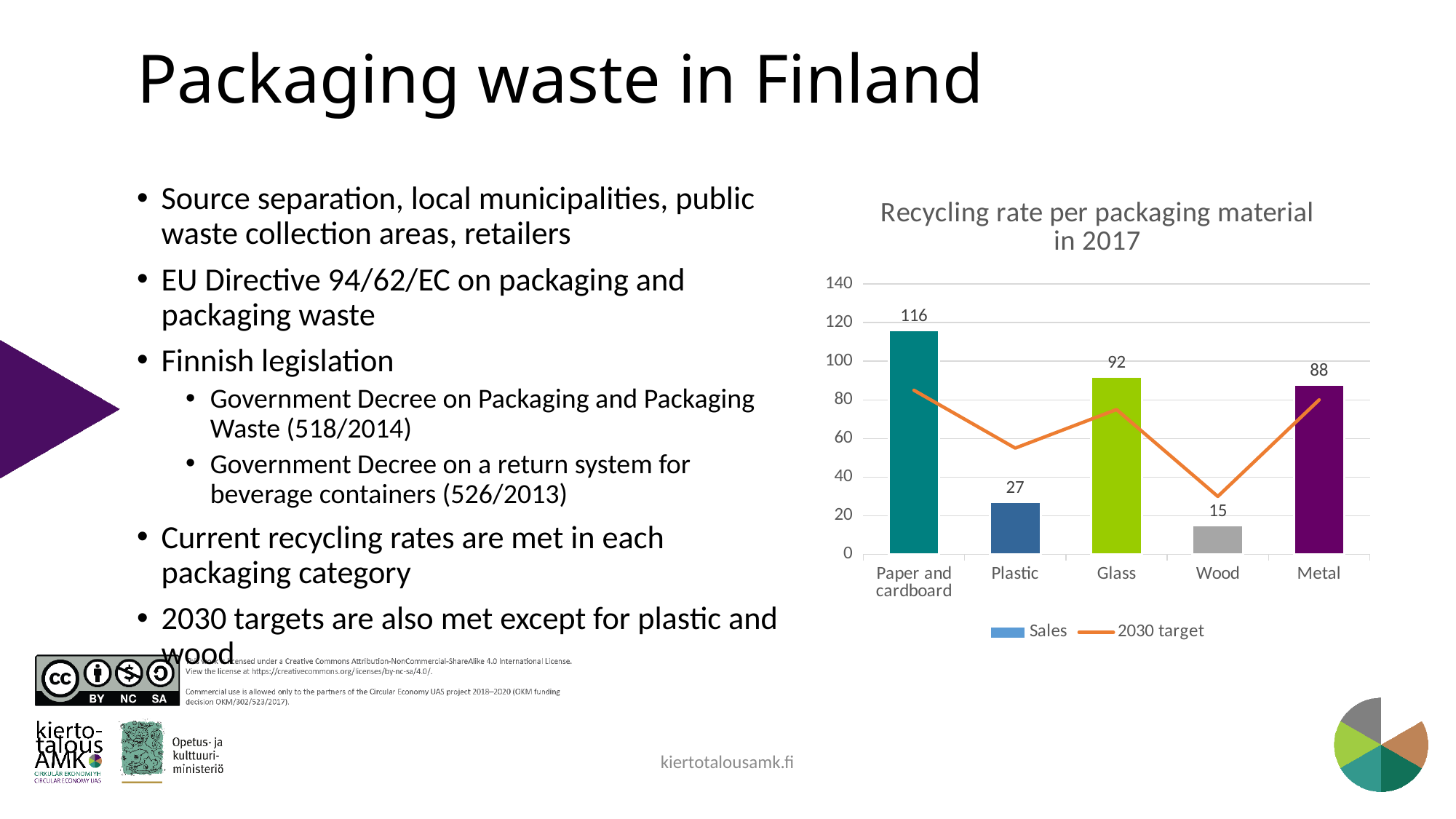
Which packaging material has the highest recycling rate in 2017? Paper and cardboard What is the recycling rate for Glass in 2017? 92 Which has a higher recycling rate, Metal or Plastic? Metal What is the recycling rate for Wood in 2017? 15 Is the 2030 target value for Plastic greater or less than 40? greater What is the recycling rate for Paper and cardboard in 2017? 116 What is the difference between the recycling rates of Glass and Plastic? 65 How many packaging material categories are shown on the x axis? 5 Which packaging material has the lowest recycling rate in 2017? Wood How many series does the legend list? 2 Is the 2030 target value for Wood greater or less than 40? less What is the title of the chart? Recycling rate per packaging material in 2017